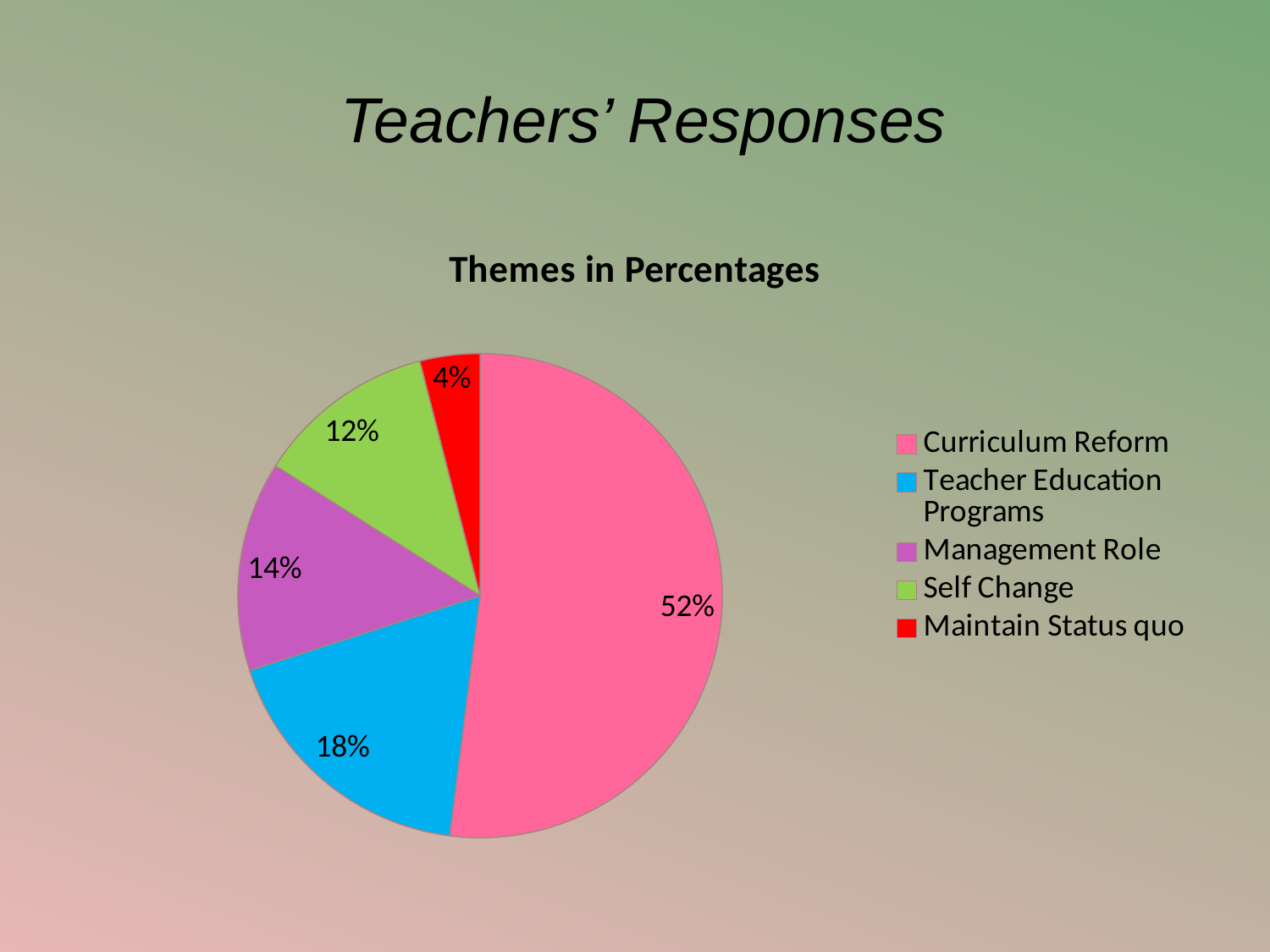
What is the value shown for Teacher Education Programs? 18% What type of chart is shown on the slide? Pie chart What percentage is shown for Maintain Status quo? 4% How many slices does the pie chart have? 5 Which theme has the smallest share of the pie? Maintain Status quo What is the title of the chart? Themes in Percentages Which is larger, Management Role or Self Change? Management Role Which theme has the largest share of the pie? Curriculum Reform What percentage is shown for Management Role? 14% What percentage of the pie does Curriculum Reform account for? 52% What is the value for Self Change? 12% What is the difference in percentage points between Curriculum Reform and Teacher Education Programs? 34